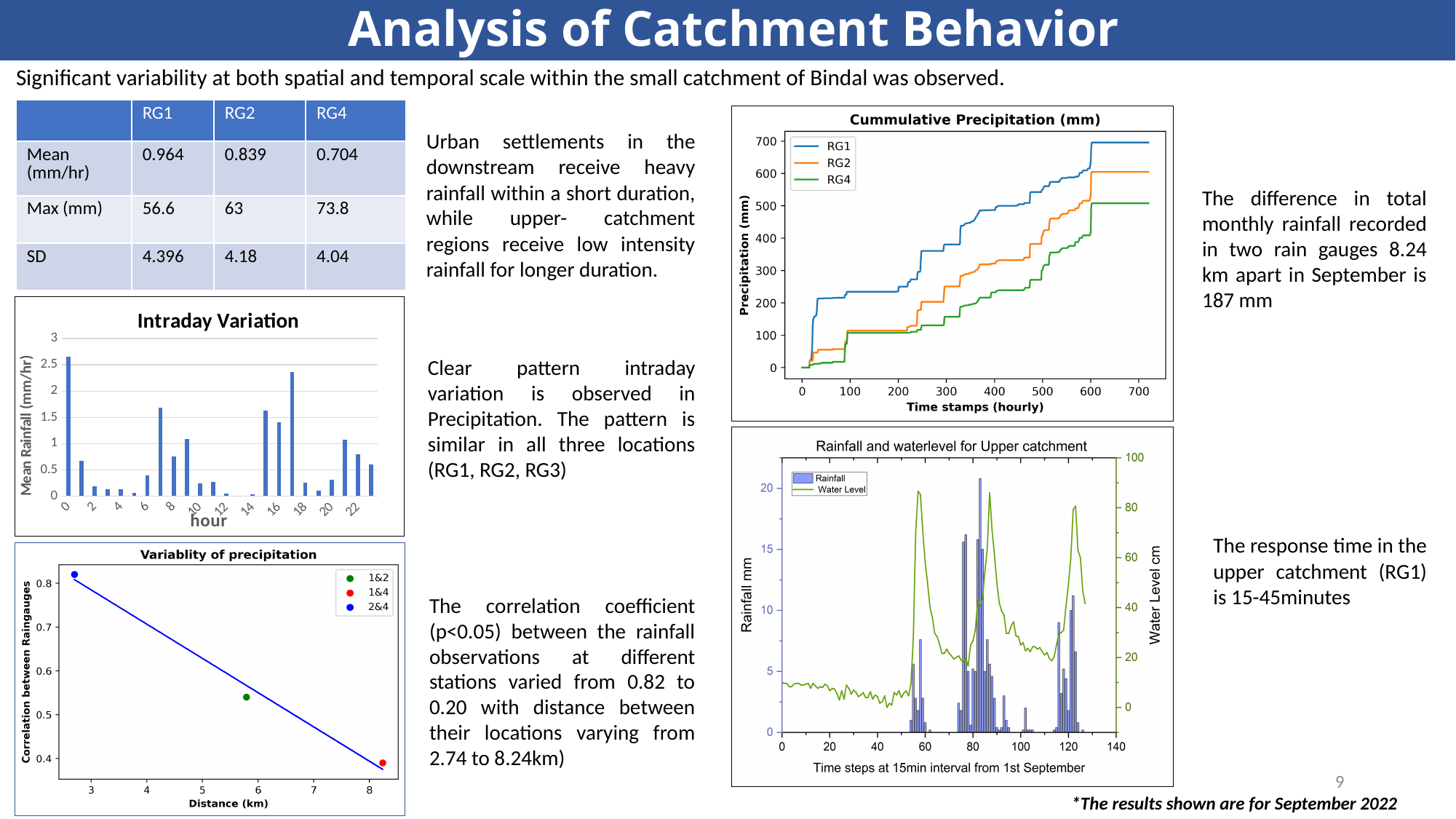
In the Intraday Variation chart, which hour has the highest mean rainfall? 0 In the Cummulative Precipitation chart, which rain gauge has the lowest cumulative precipitation at the end of the period? RG4 In the Intraday Variation chart, is the value for hour 12 greater or less than 0.5? less In the Variablity of precipitation chart, which gauge pair has the lowest correlation? 1&4 In the Cummulative Precipitation chart, which rain gauge reaches the highest cumulative precipitation by the end of the period? RG1 How many series does the legend of the Rainfall and waterlevel for Upper catchment chart list? 2 In the Cummulative Precipitation chart, is the final value for RG4 greater or less than 600? less In the Variablity of precipitation chart, is the correlation for 1&2 greater or less than 0.5? greater What kind of chart is the Intraday Variation chart? bar chart How many series does the legend of the Cummulative Precipitation chart list? 3 In the Variablity of precipitation chart, how many data points are plotted? 3